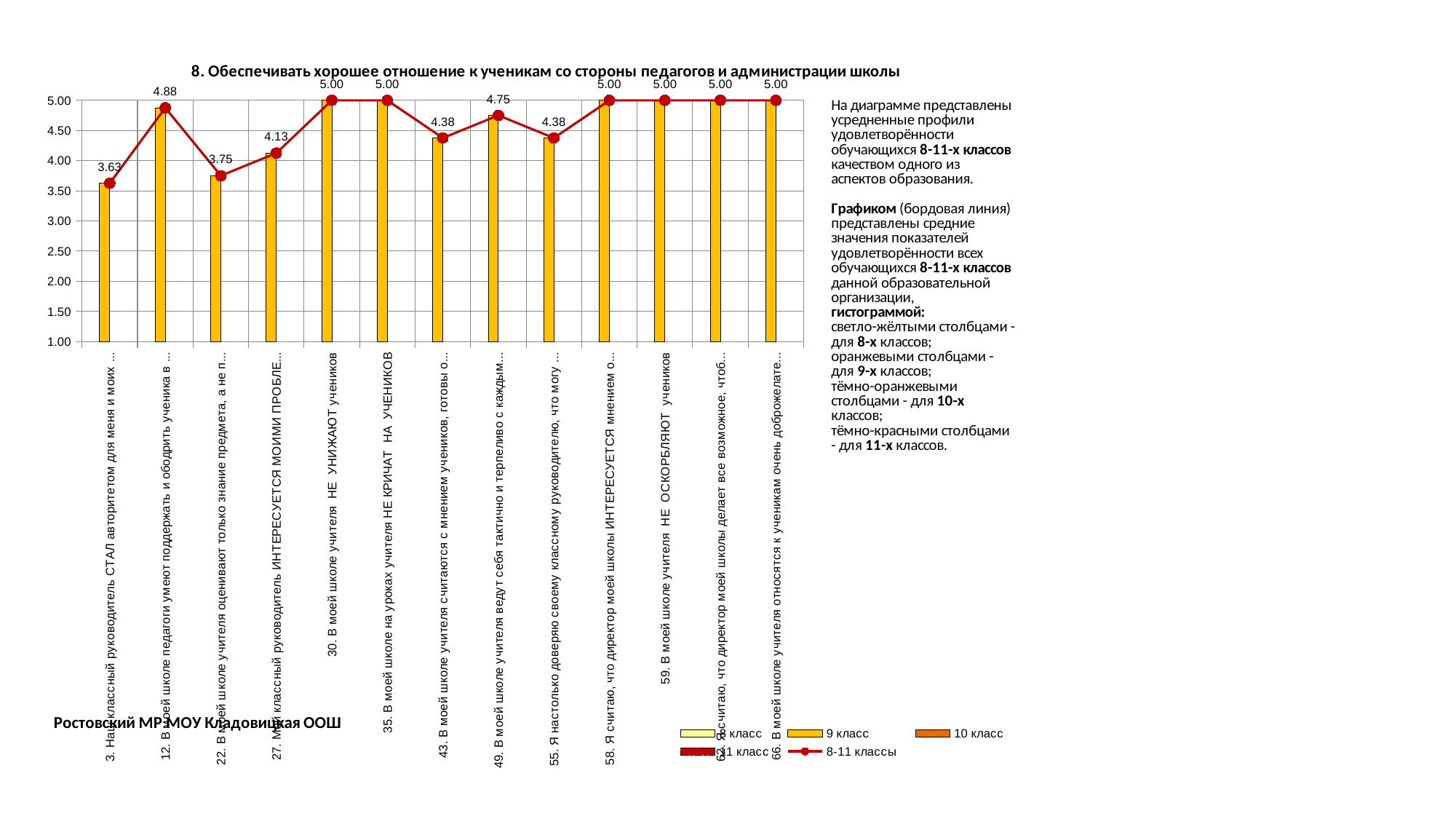
What is the value shown for statement 59 ("В моей школе учителя НЕ ОСКОРБЛЯЮТ учеников")? 5.00 What kind of chart is shown on the slide? A bar chart combined with a line chart What is the value shown for statement 12 ("В моей школе педагоги умеют поддержать и ободрить ученика...")? 4.88 Which has a higher value: statement 49 or statement 43? Statement 49 What is the difference between the values for statement 12 and statement 22? 1.13 How many series does the legend list? 5 How many statements have a value of exactly 5.00? 6 Which statement has the lowest value on the chart? Statement 3 (3.63) How many statements (categories) are plotted on the chart? 13 What is the average value (8-11 классы line) for the statement "30. В моей школе учителя НЕ УНИЖАЮТ учеников"? 5.00 Is the value for statement 22 greater or less than 4.00? less What is the value shown for statement 3 ("Наш классный руководитель СТАЛ авторитетом...")? 3.63